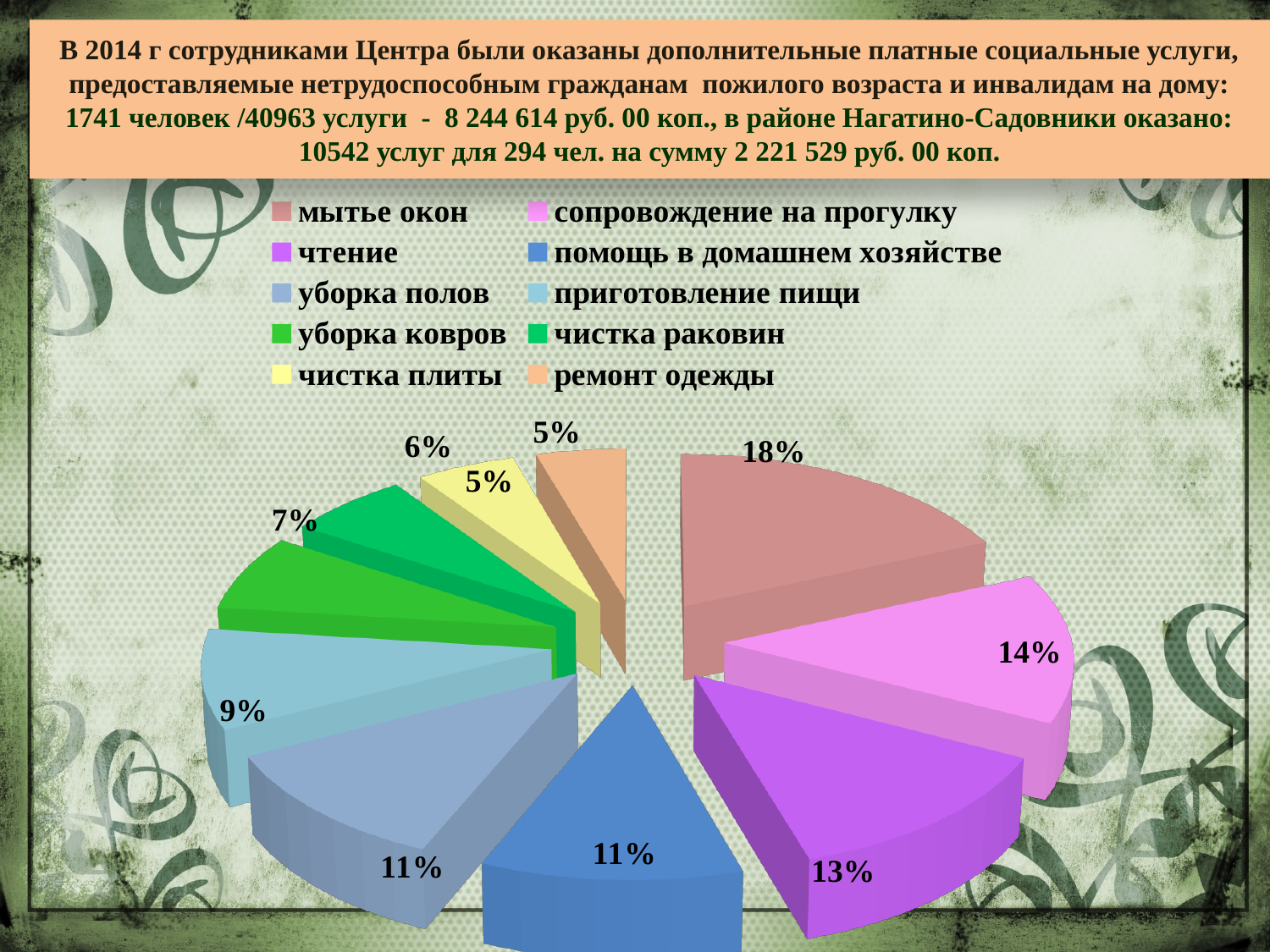
Which category has the largest slice of the pie? мытье окон What share of the pie does приготовление пищи have? 9% Which legend entry is shown in yellow? чистка плиты How many slices does the pie chart have? 10 What is the difference between the shares of мытье окон and чтение? 5% Which has a larger share, сопровождение на прогулку or помощь в домашнем хозяйстве? сопровождение на прогулку What share of the pie does сопровождение на прогулку have? 14% What share of the pie does мытье окон have? 18% What share of the pie does уборка ковров have? 7% What kind of chart is shown on the slide? pie chart What share of the pie does чтение have? 13% What is the combined share of чистка плиты and ремонт одежды? 10%